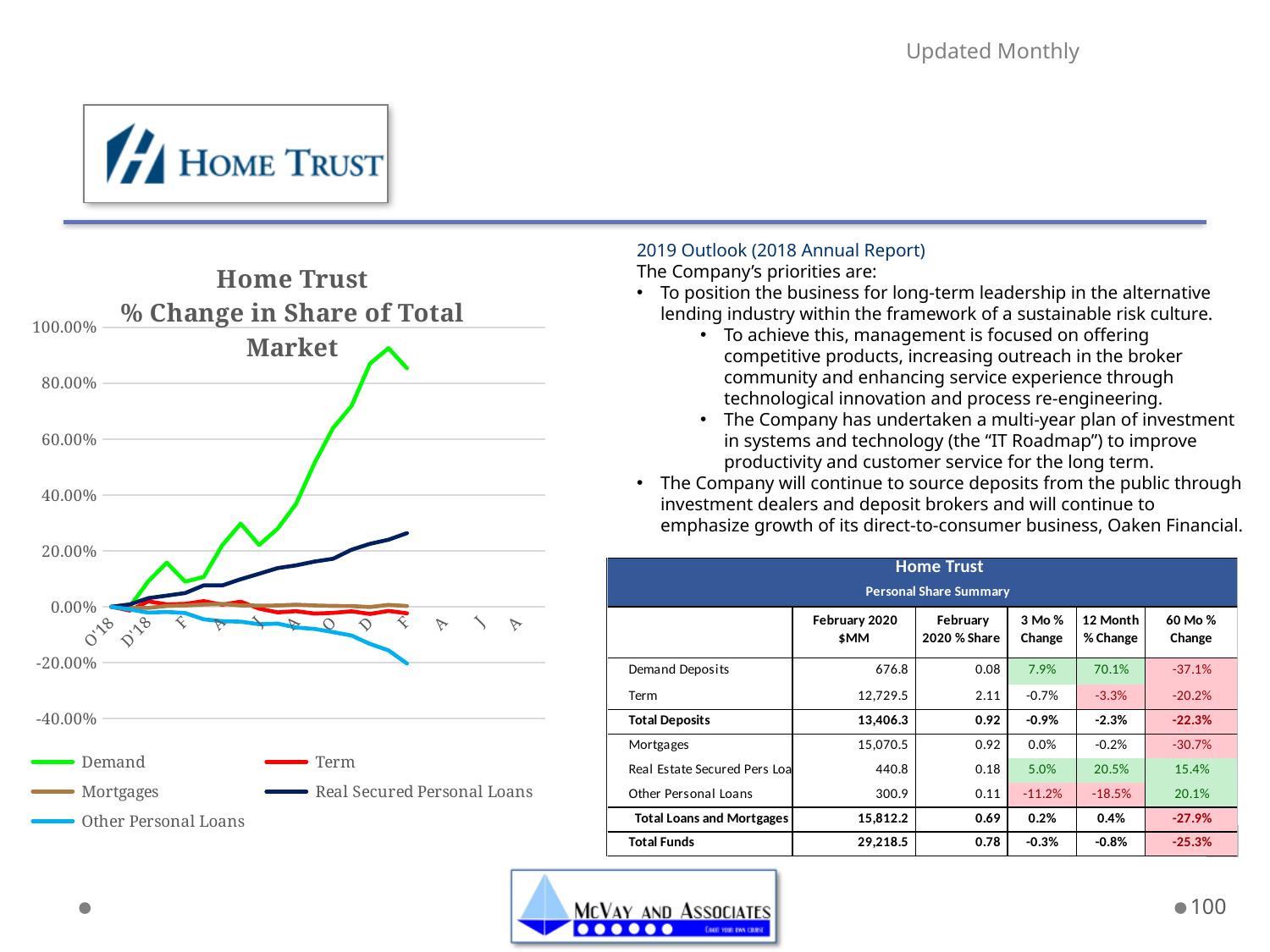
At the right end of the chart, which is larger: the Demand series or the Term series? Demand Does the Other Personal Loans series generally rise or fall from left to right along the x axis? Fall Is the final value of the Other Personal Loans series greater or less than 0.00%? less What is the title of the chart? Home Trust % Change in Share of Total Market Does the Demand series generally rise or fall from left to right along the x axis? Rise Is the final value of the Demand series greater or less than 60.00%? greater Which series reaches the lowest value on the chart? Other Personal Loans Which series reaches the highest value on the chart? Demand Does the Real Secured Personal Loans series generally rise or fall from left to right along the x axis? Rise How many series does the legend of the chart list? 5 What kind of chart is shown on the slide? Line chart Which colour is used for the Demand series in the chart? Green